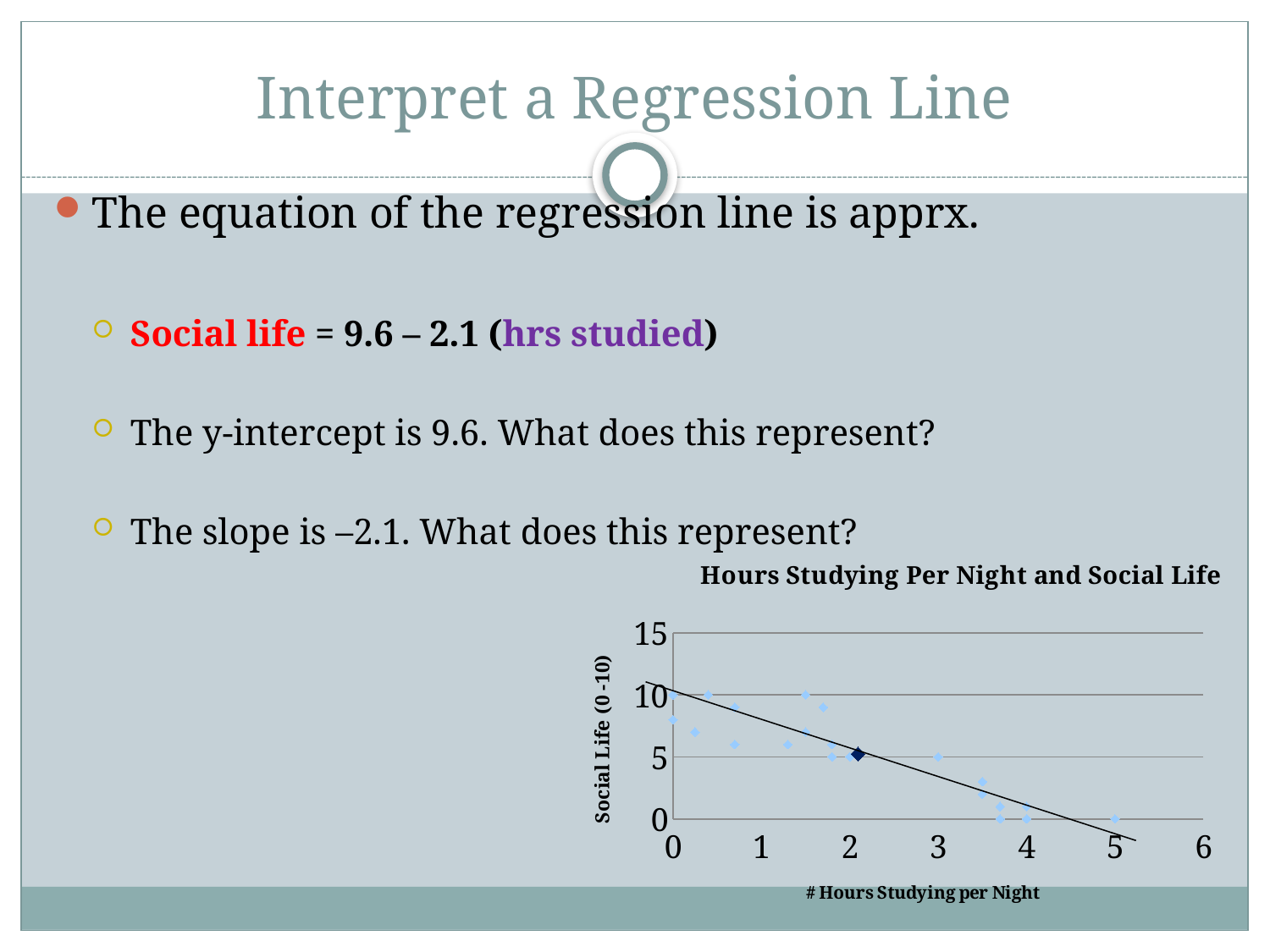
What is the highest value shown on the y axis of the chart? 15 What kind of chart is shown on the slide? Scatter plot Is the social life value for the point at 0 hours studying greater or less than 5? greater Is the social life value for the point at 1.5 hours studying greater or less than 5? greater Is the social life value for the point at 4 hours studying greater or less than 5? less What is the title of the chart on the slide? Hours Studying Per Night and Social Life Do the social life values rise or fall as hours studying per night increase along the x axis? Fall Which has the larger social life value: the point at 0 hours studying or the point at 5 hours studying? The point at 0 hours studying What is the label of the x axis of the chart? # Hours Studying per Night